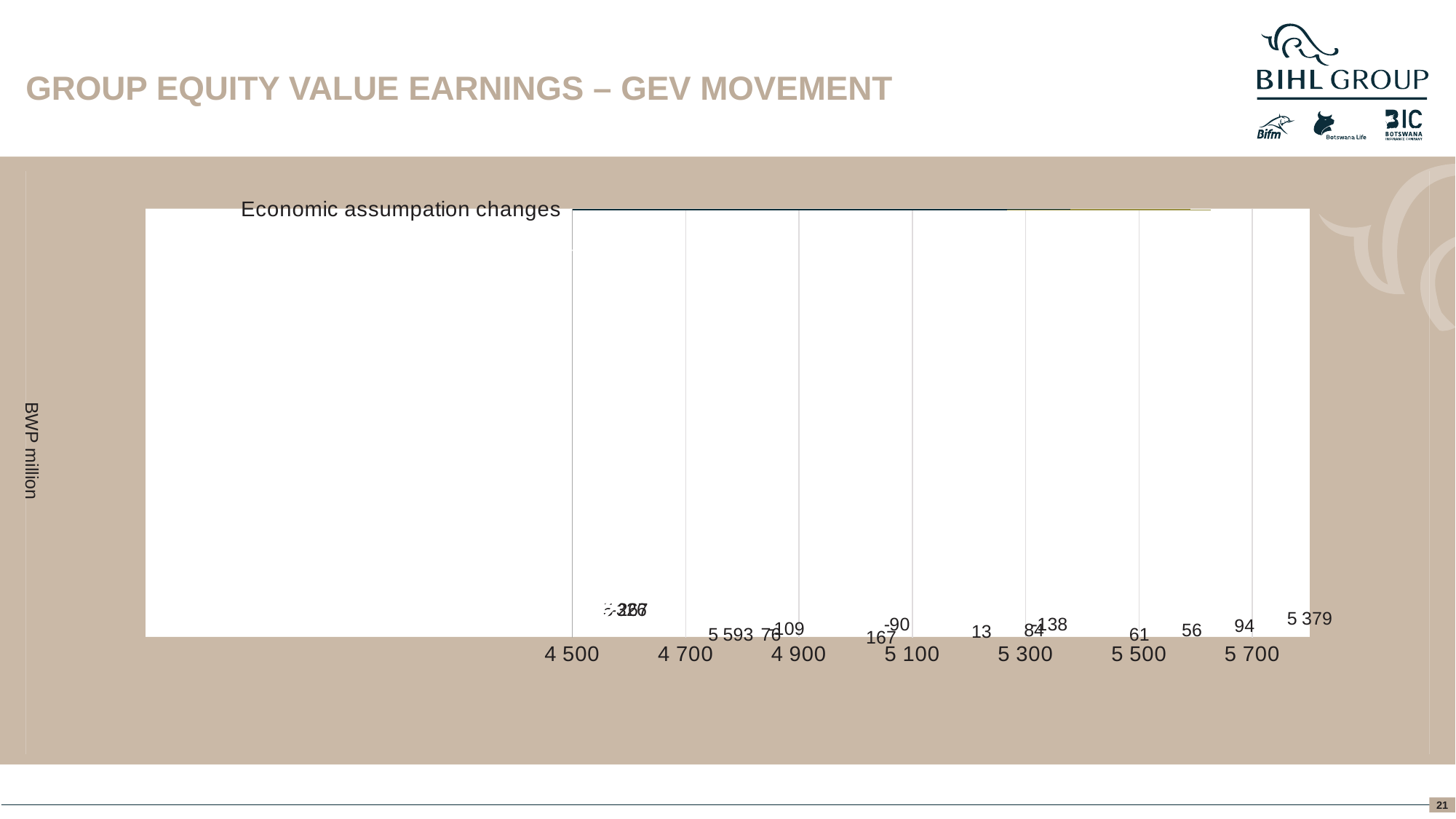
Which of the two large data labels on the chart is larger, 5 593 or 5 379? 5 593 What is the only readable category label shown on the chart? Economic assumpation changes How many tick values are printed on the horizontal axis of the chart? 7 What is the label on the vertical axis of the chart? BWP million What is the highest tick value shown on the horizontal axis of the chart? 5 700 What is the largest value printed as a data label on the chart? 5 593 What is the rightmost data label printed on the chart? 5 379 What is the lowest tick value shown on the horizontal axis of the chart? 4 500 What is the difference between the data labels 5 593 and 5 379 on the chart? 214